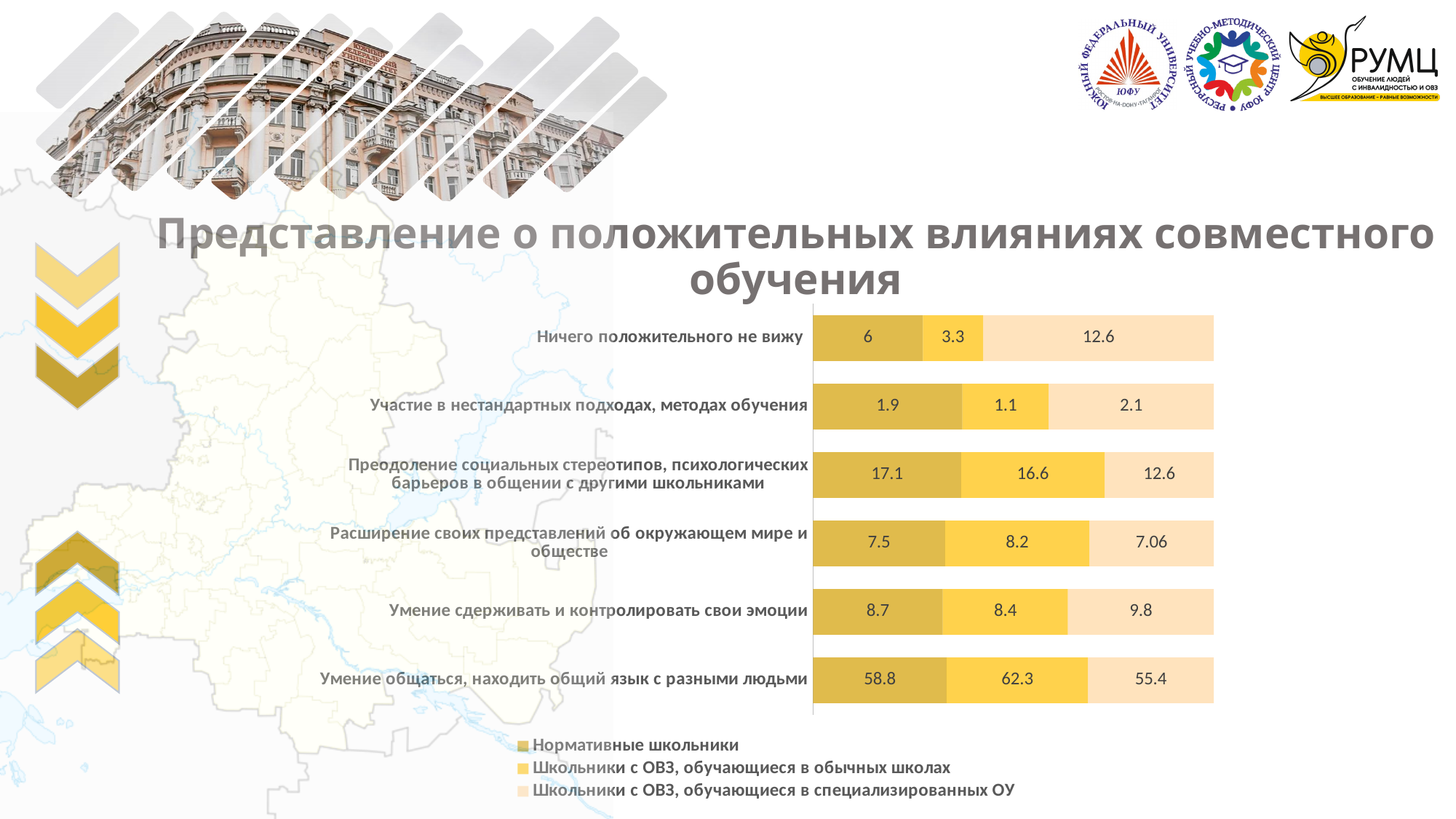
Which category has the lowest value for Школьники с ОВЗ, обучающиеся в обычных школах? Участие в нестандартных подходах, методах обучения What value is shown for Школьники с ОВЗ, обучающиеся в специализированных ОУ in the category Ничего положительного не вижу? 12.6 What value is shown for Школьники с ОВЗ, обучающиеся в обычных школах in the category Расширение своих представлений об окружающем мире и обществе? 8.2 How many series does the legend list? 3 Which category has the highest value for Нормативные школьники? Умение общаться, находить общий язык с разными людьми What value is shown for Нормативные школьники in the category Умение сдерживать и контролировать свои эмоции? 8.7 What is the difference between the values for Школьники с ОВЗ, обучающиеся в обычных школах and Нормативные школьники in the category Умение общаться, находить общий язык с разными людьми? 3.5 What value is shown for Нормативные школьники in the category Умение общаться, находить общий язык с разными людьми? 58.8 What is the title of the slide? Представление о положительных влияниях совместного обучения What kind of chart is shown on the slide? Stacked bar chart How many categories are shown on the chart? 6 In the category Преодоление социальных стереотипов, психологических барьеров в общении с другими школьниками, which series has the larger value: Нормативные школьники or Школьники с ОВЗ, обучающиеся в специализированных ОУ? Нормативные школьники